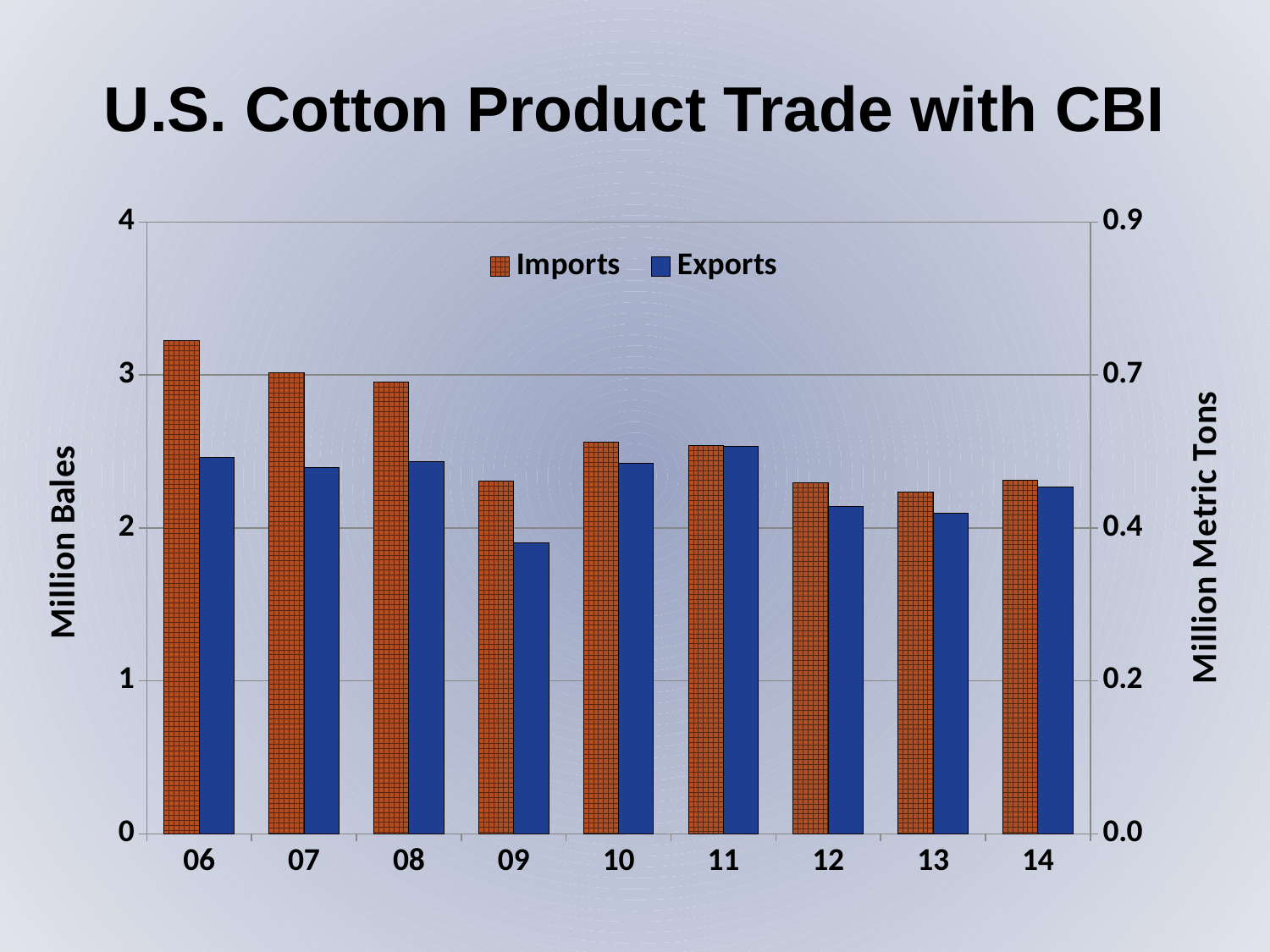
What is the label on the left vertical axis? Million Bales Is the Exports value for 09 greater or less than 2 million bales? less Is the Imports value for 09 greater or less than 2 million bales? greater Do Imports generally rise or fall from 06 to 14? Fall Which year has the lowest Exports value? 09 How many years are shown on the x axis? 9 Which is larger, Imports in 06 or Imports in 09? Imports in 06 Which year has the highest Imports value? 06 How many series does the legend list? 2 In 06, which is larger, Imports or Exports? Imports What kind of chart is shown on the slide? Bar chart Is the Imports value for 06 greater or less than 3 million bales? greater